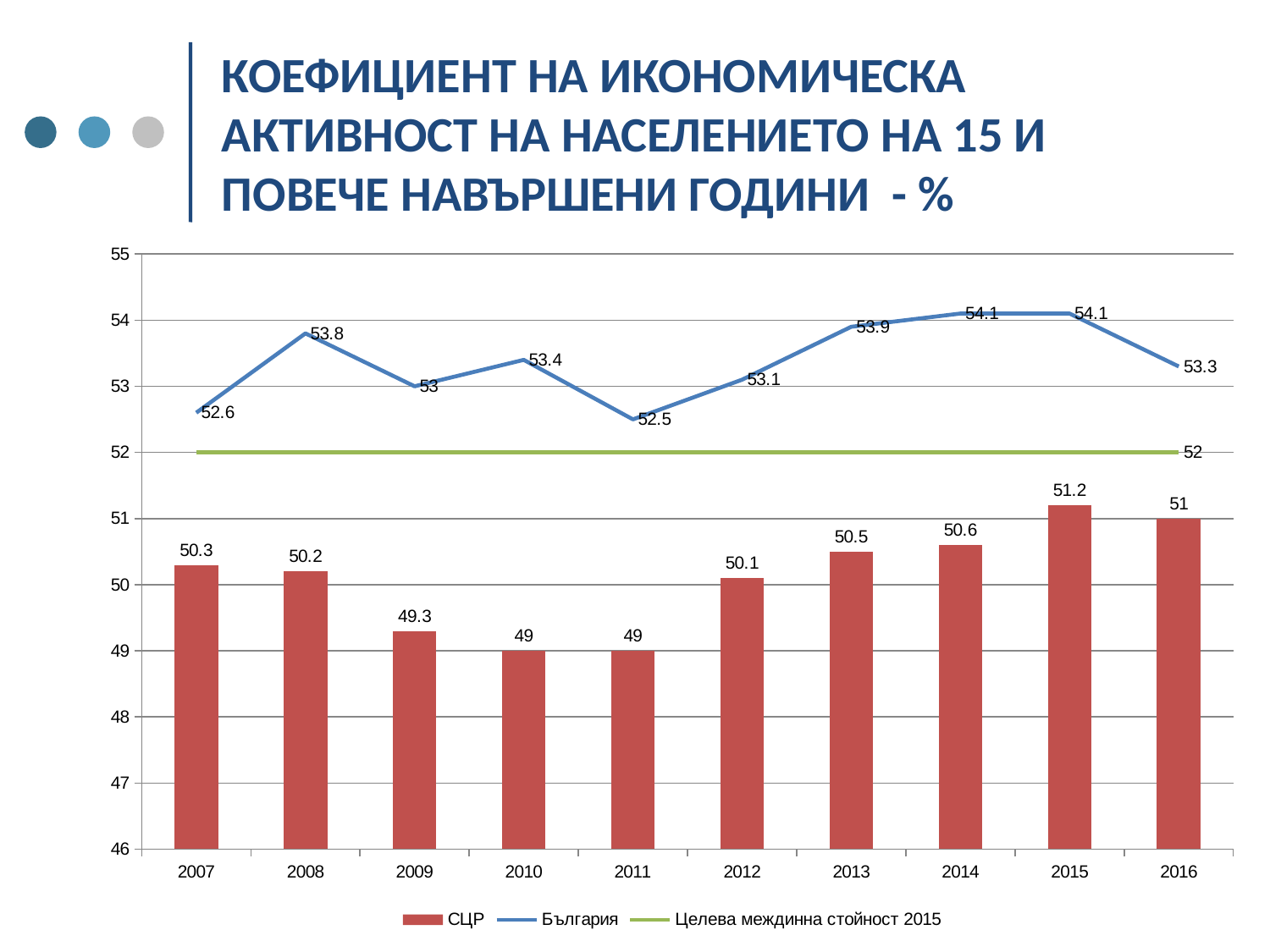
What is the difference between the България value and the СЦР value in 2016? 2.3 Does the СЦР value rise or fall from 2012 to 2015? rise In which year is the СЦР value the highest? 2015 What is the value of България for 2008? 53.8 What is the value of СЦР for 2015? 51.2 How many years are shown on the x axis? 10 What kind of chart is used for the СЦР series? bar chart In which year is the България value the lowest? 2011 What colour is the България line? blue How many series does the legend list? 3 What is the value of the Целева междинна стойност 2015 line? 52 Which is larger, the СЦР value for 2012 or for 2013? 2013